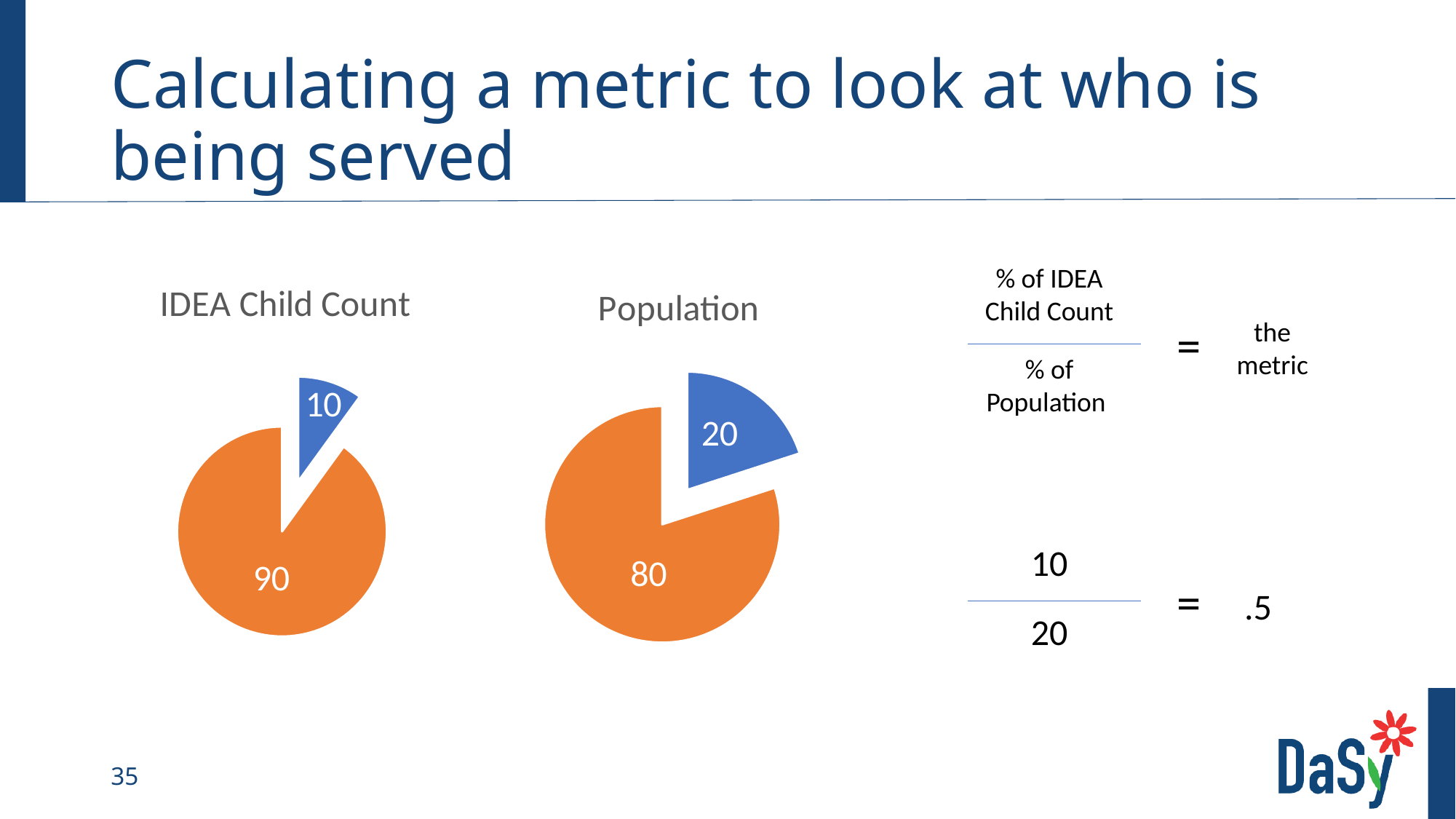
In the "IDEA Child Count" pie chart, what value is shown on the blue slice? 10 How many pie charts are shown on the slide? 2 In the "IDEA Child Count" pie chart, what value is shown on the orange slice? 90 What kind of chart is the "IDEA Child Count" chart? pie chart In the "IDEA Child Count" pie chart, which slice is the largest? the orange slice (90) In the "Population" pie chart, which slice is the smallest? the blue slice (20) In the "Population" pie chart, what is the difference between the orange slice and the blue slice? 60 Which is larger: the blue slice in the "IDEA Child Count" chart or the blue slice in the "Population" chart? the blue slice in the Population chart How many slices does the "Population" pie chart have? 2 In the "IDEA Child Count" pie chart, what share of the total does the blue slice represent? 10% In the "Population" pie chart, what value is shown on the blue slice? 20 In the "Population" pie chart, what value is shown on the orange slice? 80